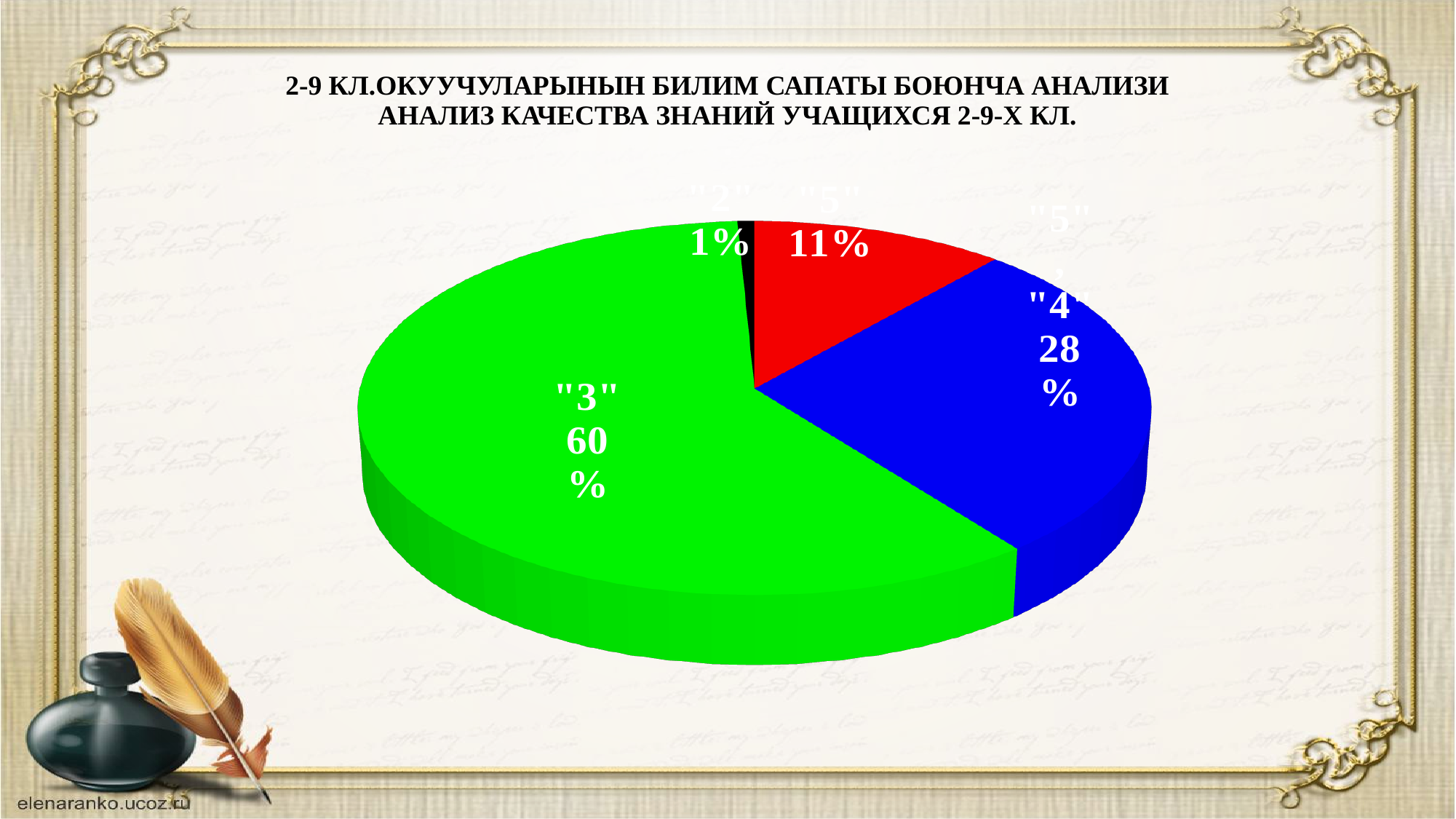
Which slice is larger, "4" or "5"? "4" What percentage of the pie does the "5" slice represent? 11% What colour is the "4" slice? blue What colour is the "3" slice? green How many slices does the pie chart have? 4 Which slice has the smallest share of the pie? "2" What kind of chart is shown on the slide? pie chart What percentage of the pie does the "2" slice represent? 1% What percentage of the pie does the "3" slice represent? 60% What percentage of the pie does the "4" slice represent? 28% What is the difference in percentage points between the "3" slice and the "4" slice? 32 Which slice has the largest share of the pie? "3"